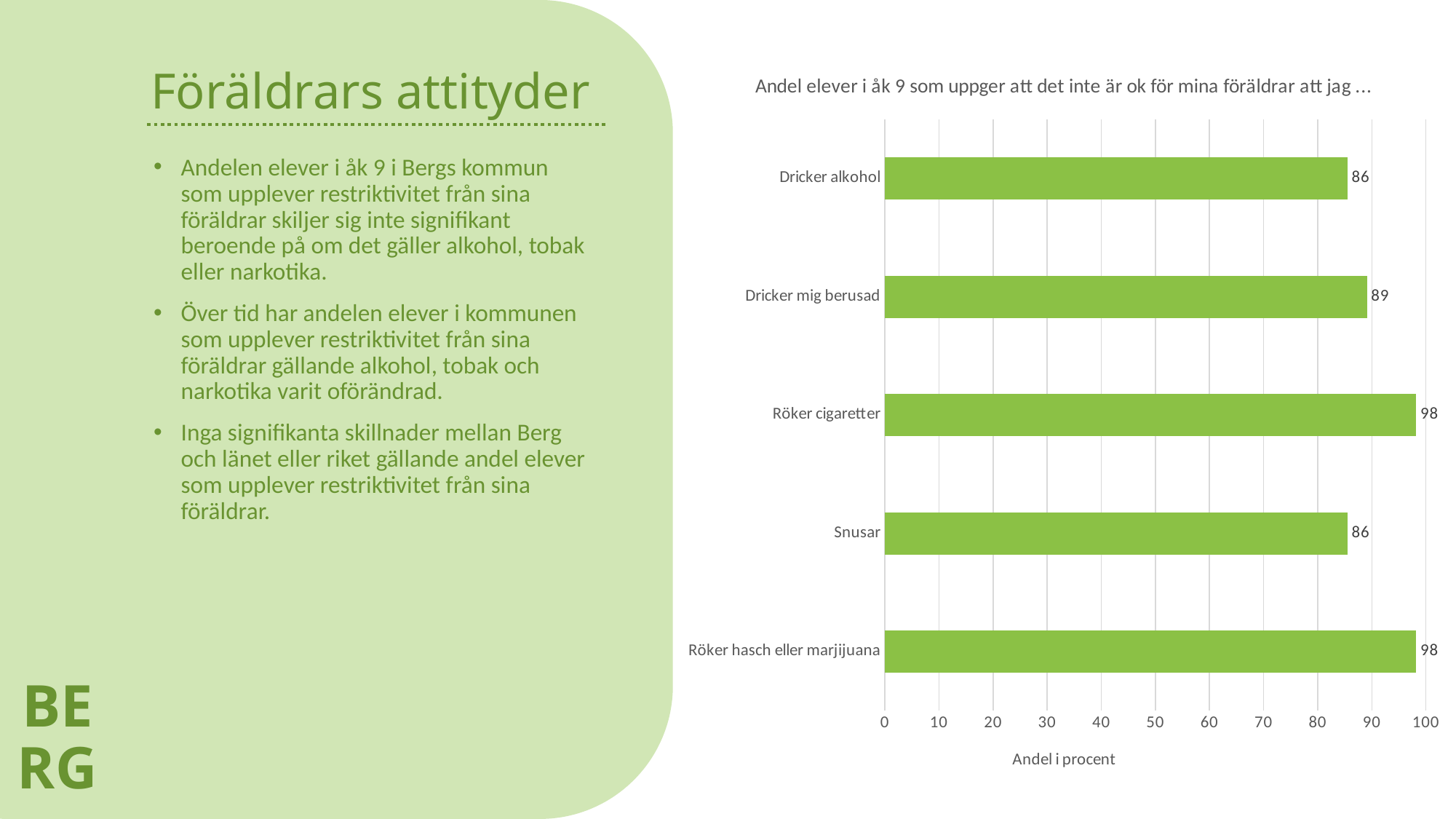
How many categories are shown in the chart? 5 What kind of chart is shown on the slide? bar chart What is the value for Dricker alkohol? 86 What is the value for Snusar? 86 What is the difference between the values for Dricker mig berusad and Snusar? 3 What is the value for Dricker mig berusad? 89 Which is larger, the value for Dricker mig berusad or the value for Dricker alkohol? Dricker mig berusad Is the value for Snusar greater or less than 90? less What is the label of the horizontal axis of the chart? Andel i procent What is the value for Röker cigaretter? 98 What is the value for Röker hasch eller marjijuana? 98 What is the difference between the values for Röker cigaretter and Dricker alkohol? 12